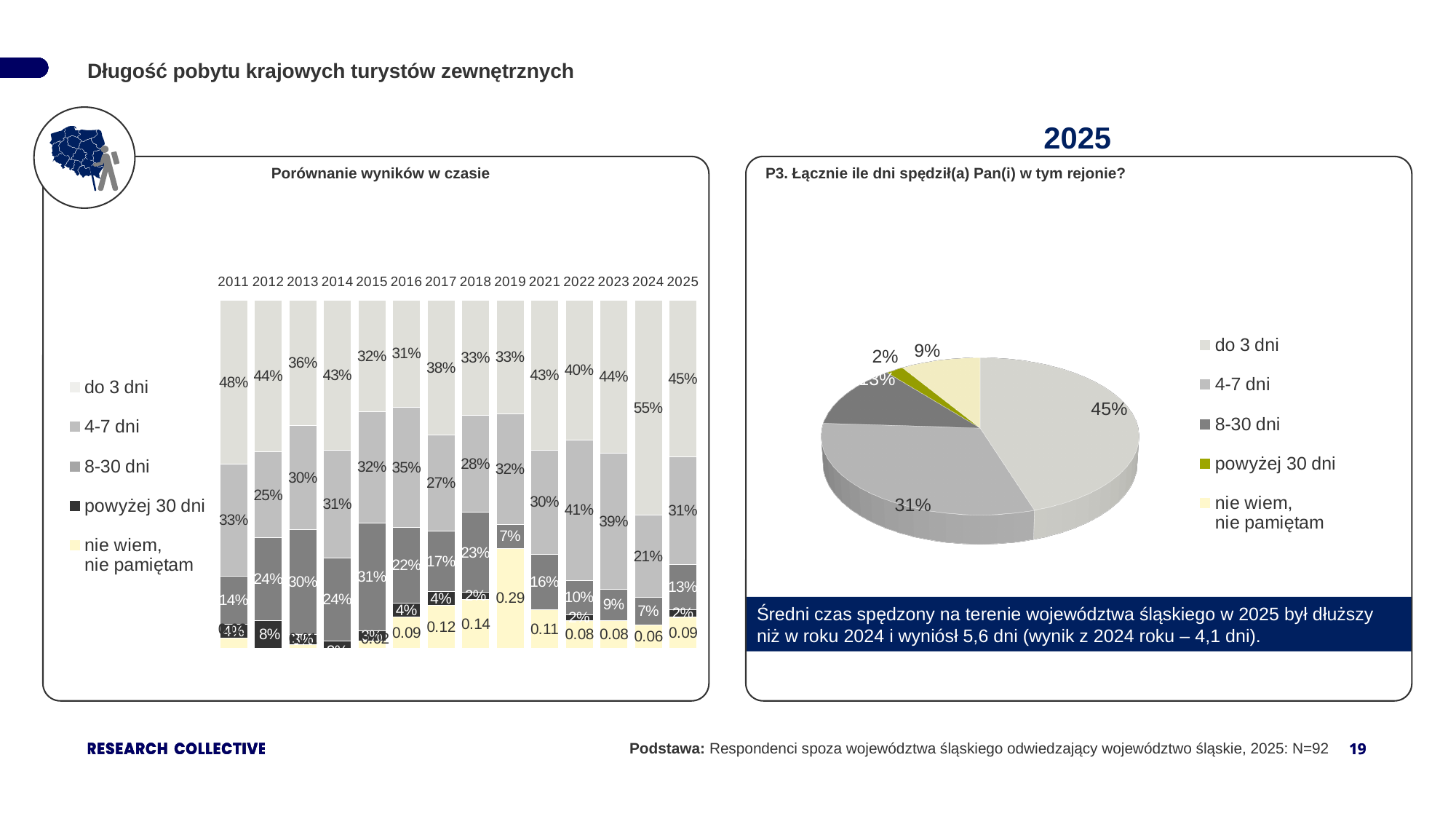
In the right pie chart for 2025, what share does "4-7 dni" have? 31% In the left chart "Porównanie wyników w czasie", what is the value for "4-7 dni" in 2022? 41% In the left chart "Porównanie wyników w czasie", what is the difference between the "do 3 dni" values for 2024 and 2025? 10 percentage points In the left chart "Porównanie wyników w czasie", how many series does the legend list? 5 In the left chart "Porównanie wyników w czasie", how many years are shown on the x axis? 14 What kind of chart is the left chart titled "Porównanie wyników w czasie"? Stacked bar chart In the left chart "Porównanie wyników w czasie", which year has the larger value for "8-30 dni": 2013 or 2019? 2013 What kind of chart is the right chart titled "P3. Łącznie ile dni spędził(a) Pan(i) w tym rejonie?"? Pie chart In the right pie chart for 2025, which category has the smallest slice? powyżej 30 dni In the left chart "Porównanie wyników w czasie", what is the value for "do 3 dni" in 2024? 55% In the left chart "Porównanie wyników w czasie", which year has the highest value for "do 3 dni"? 2024 In the left chart "Porównanie wyników w czasie", what is the value for "nie wiem, nie pamiętam" in 2019? 0.29